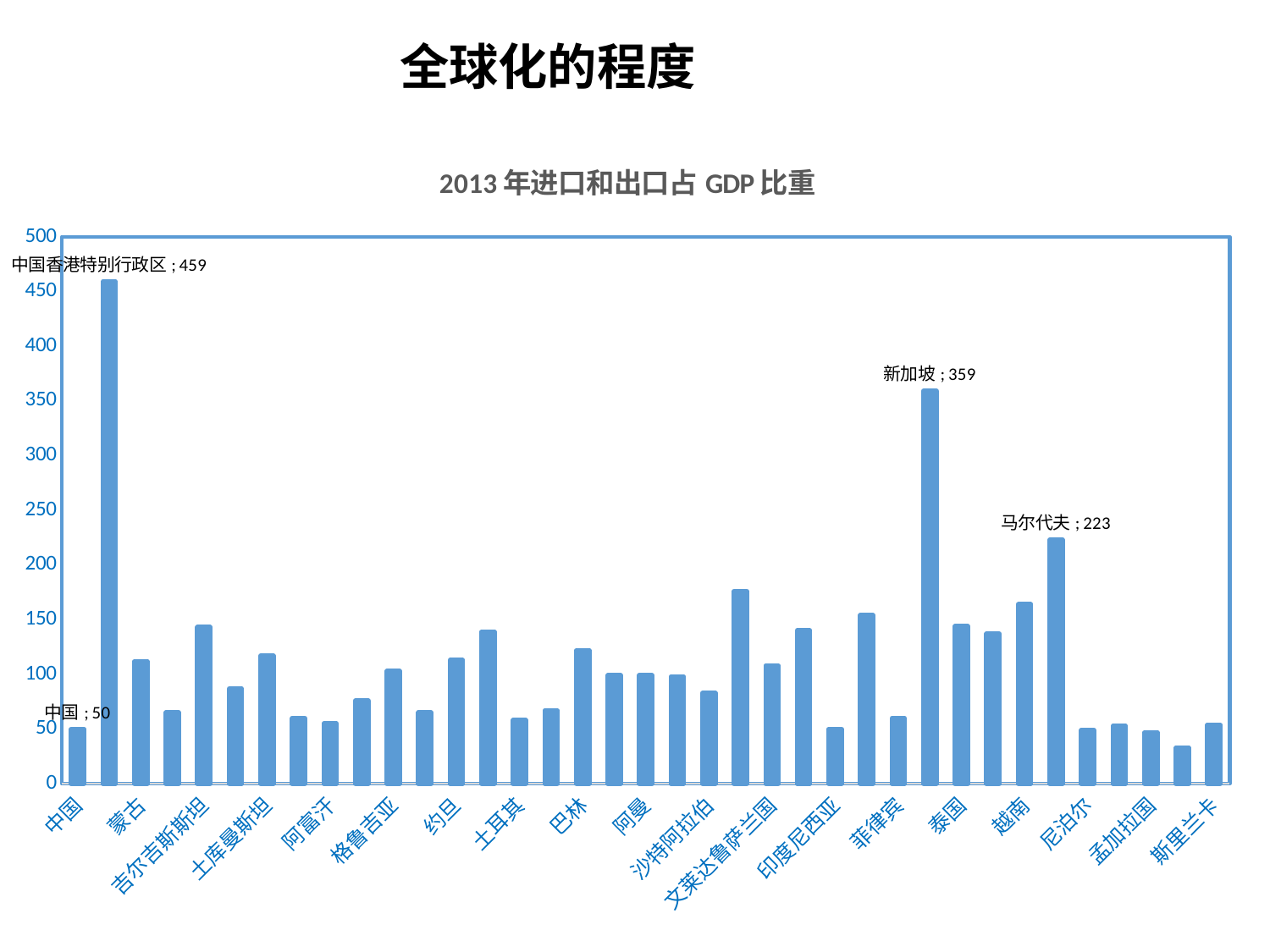
What is the value for 中国香港特别行政区? 459 What is the value for 马尔代夫? 223 Is the value for 蒙古 greater or less than 100? greater Is the value for 阿富汗 greater or less than 100? less What is the value for 新加坡? 359 What kind of chart is shown on the slide? bar chart What is the difference between the values for 中国香港特别行政区 and 新加坡? 100 Which category has the highest value? 中国香港特别行政区 What is the value for 中国? 50 Which is larger, the value for 新加坡 or the value for 马尔代夫? 新加坡 What is the difference between the values for 新加坡 and 马尔代夫? 136 What is the difference between the values for 中国香港特别行政区 and 中国? 409